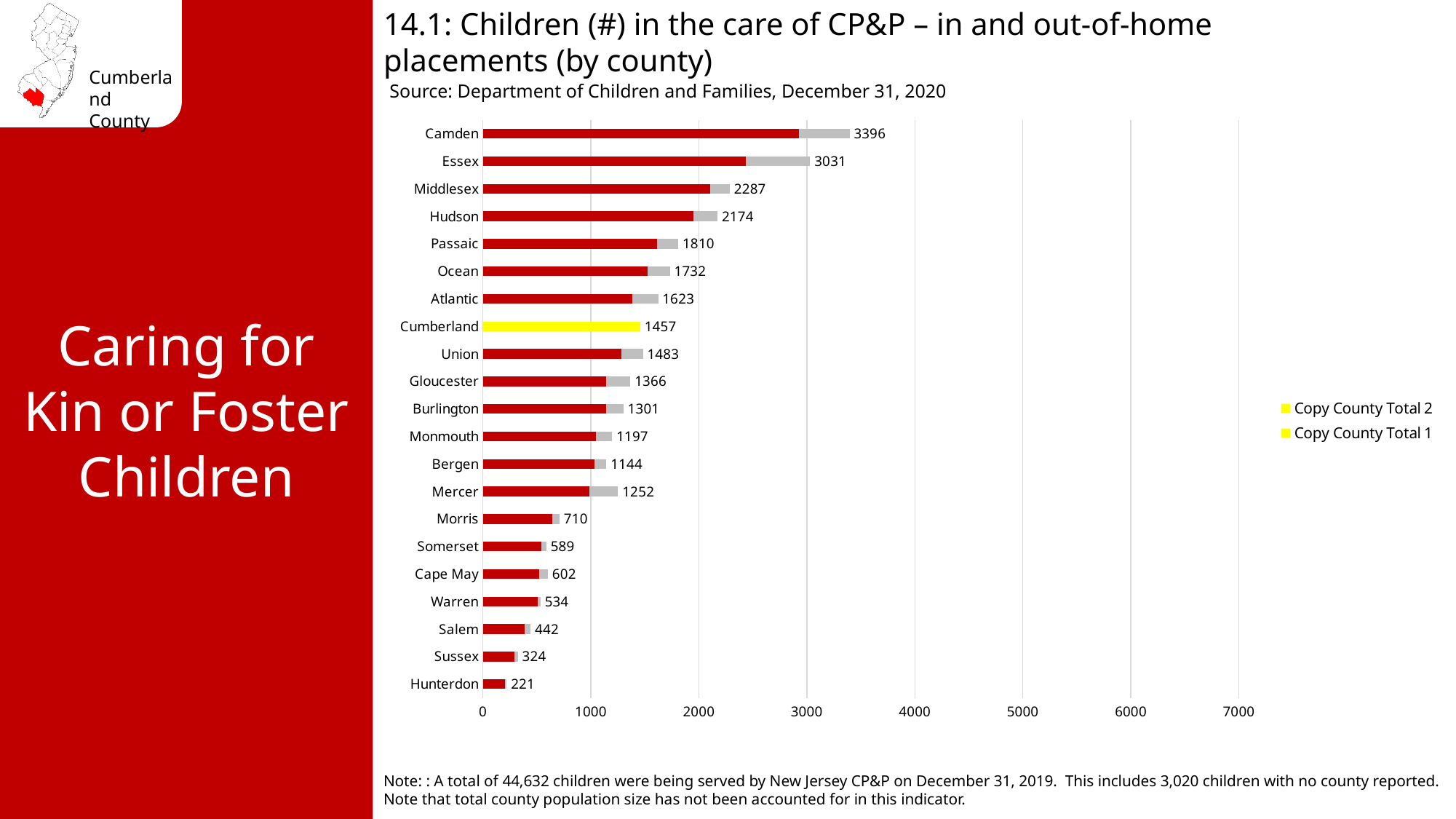
What is the labelled total for Hunterdon? 221 Which county has the lowest labelled total? Hunterdon Is the total for Middlesex greater or less than 2000? greater What is the labelled total for Camden? 3396 Which has the larger labelled total, Union or Cumberland? Union What is the difference between the labelled totals for Camden and Essex? 365 How many series does the legend list? 2 Which county has the highest labelled total? Camden What is the labelled total for Cumberland? 1457 What kind of chart is shown? Bar chart Which county's bar is highlighted in yellow? Cumberland How many counties are shown on the chart? 21